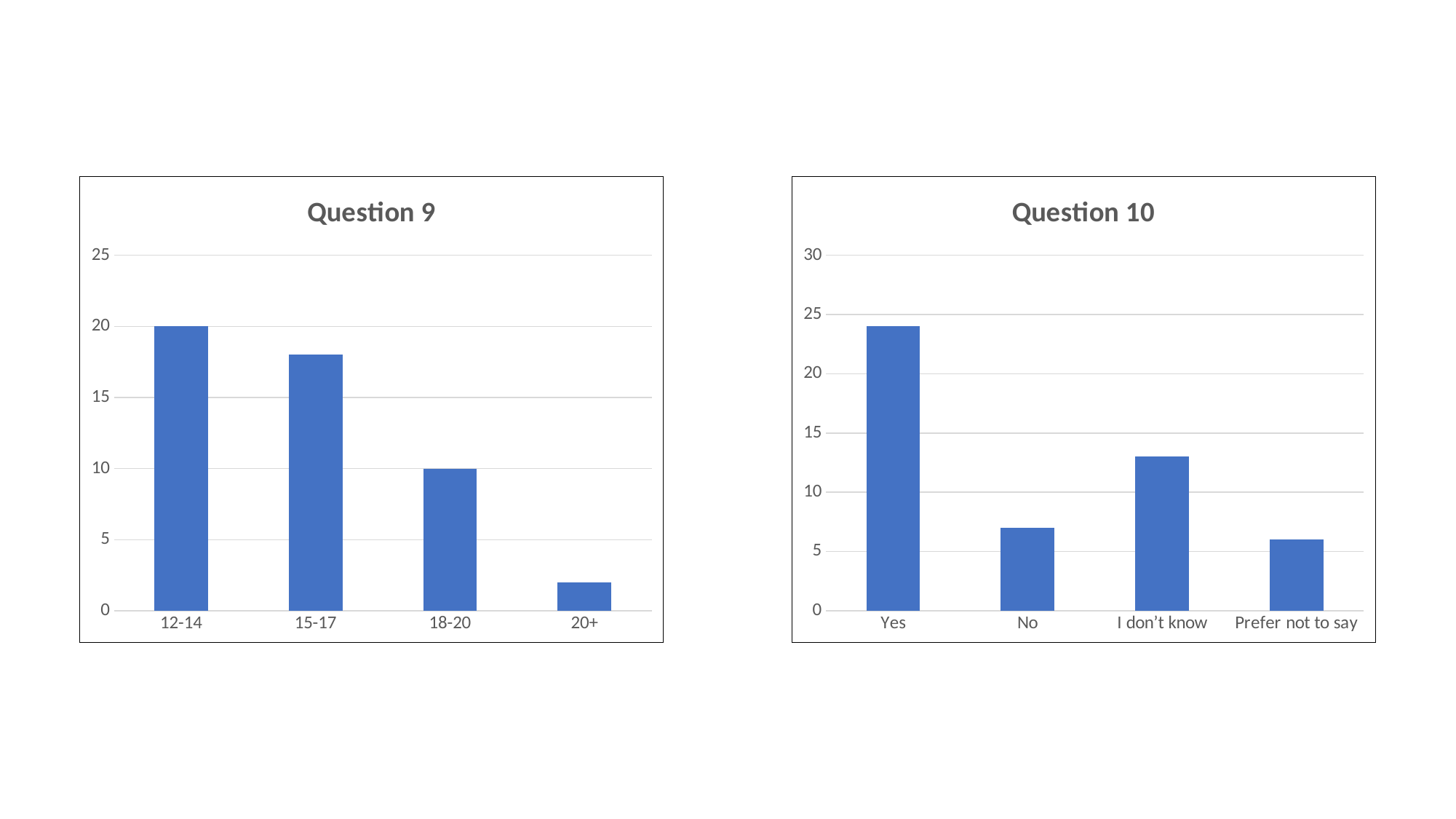
In the Question 10 chart, is the value for Yes greater or less than 20? greater In the Question 9 chart, is the value for 15-17 greater or less than 15? greater How many categories are shown in the Question 10 chart? 4 In the Question 9 chart, what is the value for the 18-20 category? 10 In the Question 10 chart, which is larger, the value for No or the value for I don't know? I don't know In the Question 10 chart, which category has the highest value? Yes In the Question 9 chart, what is the value for the 12-14 category? 20 In the Question 9 chart, which category has the highest value? 12-14 In the Question 9 chart, do the values rise or fall from left to right along the x axis? fall In the Question 9 chart, what is the difference between the values for 12-14 and 18-20? 10 In the Question 10 chart, is the value for No greater or less than 10? less In the Question 9 chart, which category has the lowest value? 20+